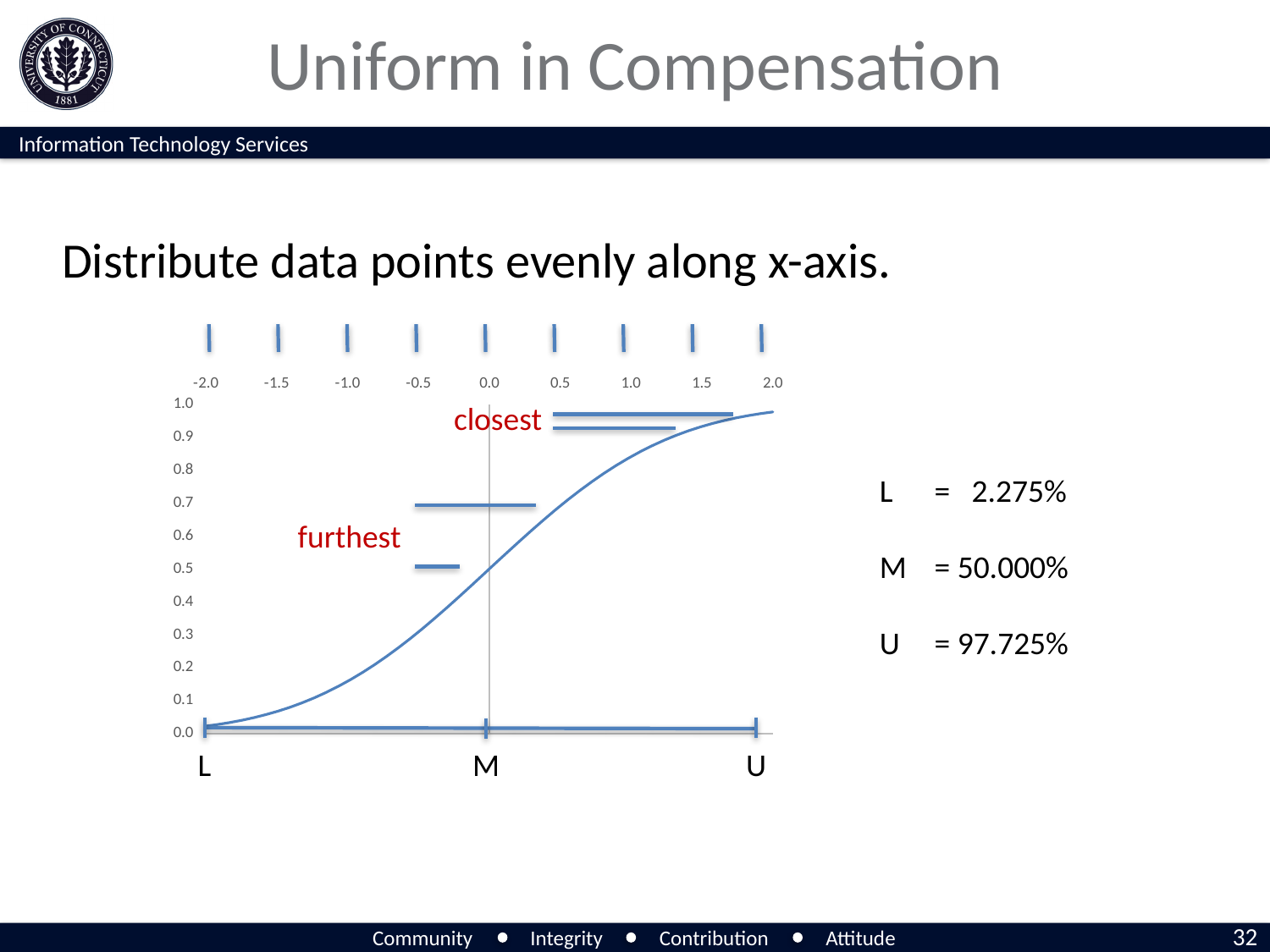
What percentage value is given for M on the slide? 50.000% What kind of chart is shown on the slide? line chart Is the value of the curve at x = 1.0 greater or less than 0.5? greater Does the curve rise or fall as the x-axis goes from -2.0 to 2.0? rise What percentage value is given for U on the slide? 97.725% Which of L, M and U has the largest percentage value? U Is the value of the curve at x = -2.0 greater or less than 0.1? less Is the value of the curve at x = 2.0 greater or less than 0.9? greater What percentage value is given for L on the slide? 2.275% How many tick marks are shown along the x-axis above the chart? 9 What are the two red annotation labels on the chart? closest and furthest